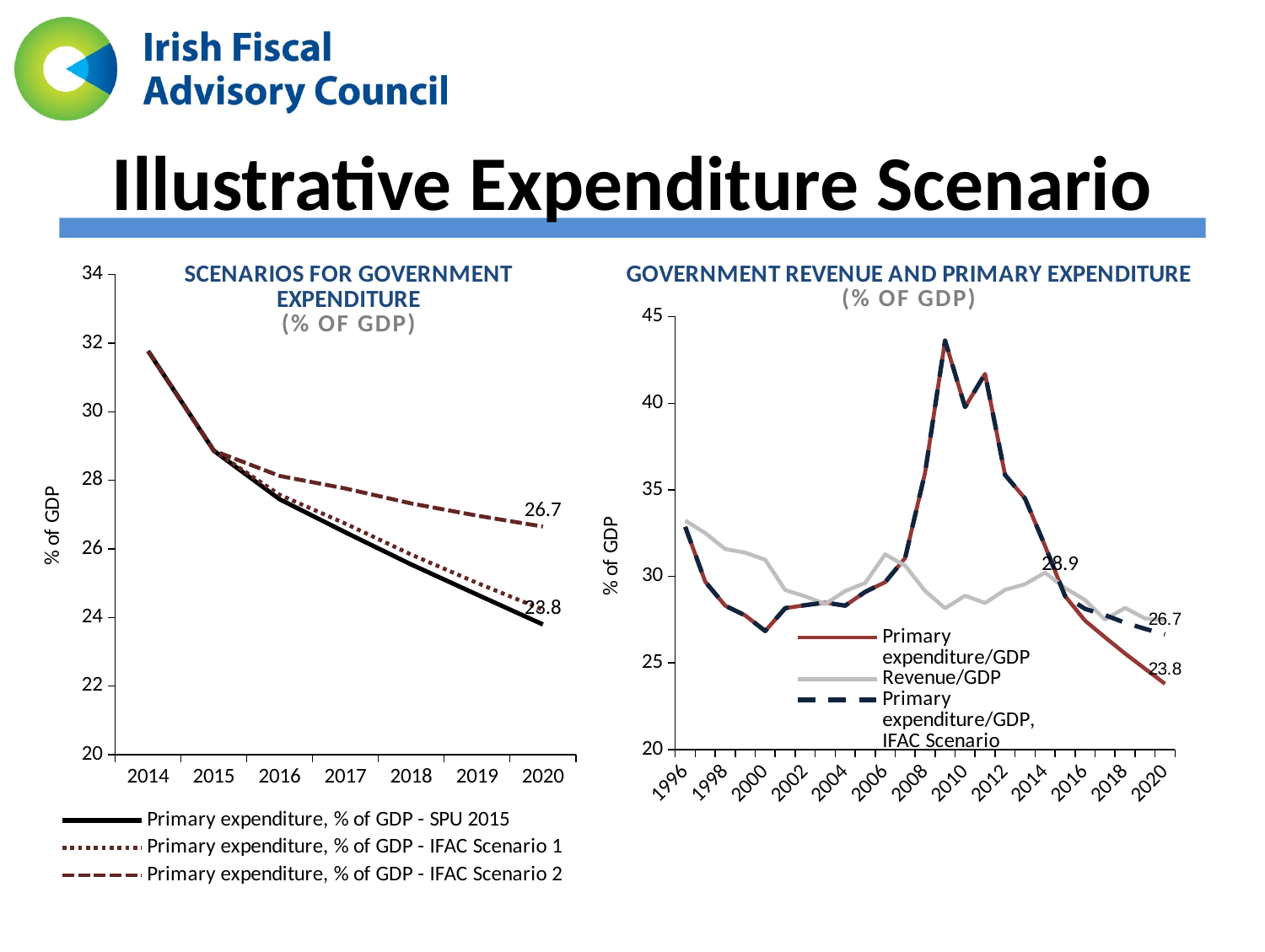
How many series does the legend of the left chart, 'Scenarios for Government Expenditure', list? 3 In the right chart, 'Government Revenue and Primary Expenditure', what value is labelled for the Primary expenditure/GDP, IFAC Scenario line in 2020? 26.7 In the right chart, 'Government Revenue and Primary Expenditure', is the peak value of Primary expenditure/GDP around 2009 greater or less than 40? greater How many years are shown on the x axis of the left chart, 'Scenarios for Government Expenditure'? 7 In the left chart, 'Scenarios for Government Expenditure', what value is labelled for IFAC Scenario 2 in 2020? 26.7 In the left chart, 'Scenarios for Government Expenditure', which is higher in 2020: IFAC Scenario 2 or SPU 2015? IFAC Scenario 2 What kind of chart is the left chart, 'Scenarios for Government Expenditure'? Line chart How many series does the legend of the right chart, 'Government Revenue and Primary Expenditure', list? 3 In the right chart, 'Government Revenue and Primary Expenditure', what value is labelled for Primary expenditure/GDP in 2020? 23.8 In the right chart, 'Government Revenue and Primary Expenditure', what is the difference between the 2020 labelled values of the IFAC Scenario line (26.7) and the Primary expenditure/GDP line (23.8)? 2.9 In the left chart, 'Scenarios for Government Expenditure', does the SPU 2015 line rise or fall from 2014 to 2020? Falls In the left chart, 'Scenarios for Government Expenditure', is the value in 2014 greater or less than 30? greater